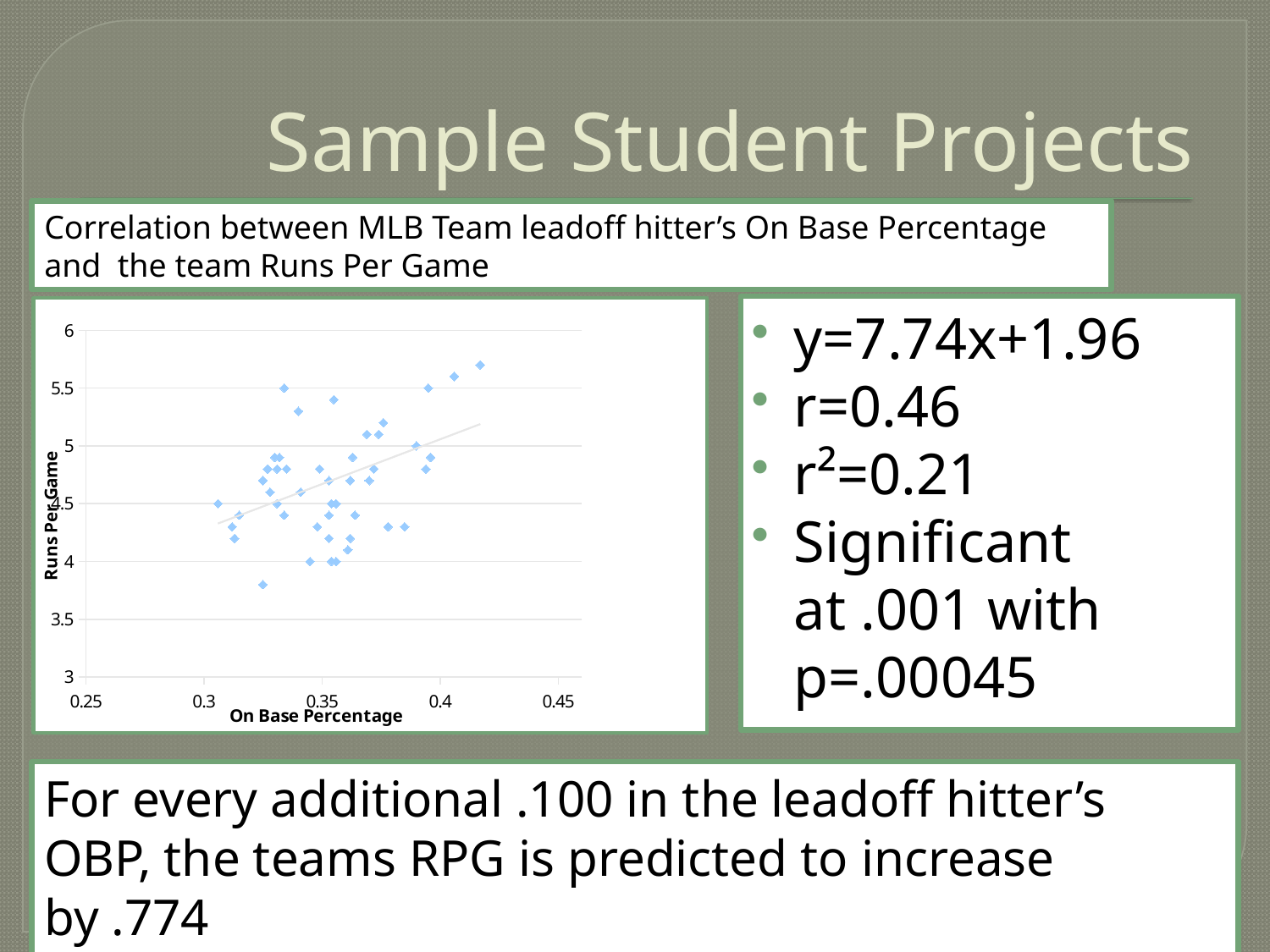
Is the On Base Percentage of the rightmost point on the chart greater or less than 0.4? greater What is the title of the x axis of the chart? On Base Percentage Is the On Base Percentage of the lowest point on the chart greater or less than 0.35? less What kind of chart is shown on the slide? scatter chart What is the title of the y axis of the chart? Runs Per Game Do the Runs Per Game values generally rise or fall as On Base Percentage increases along the x axis? rise Is the Runs Per Game value of the lowest point on the chart greater or less than 4? less